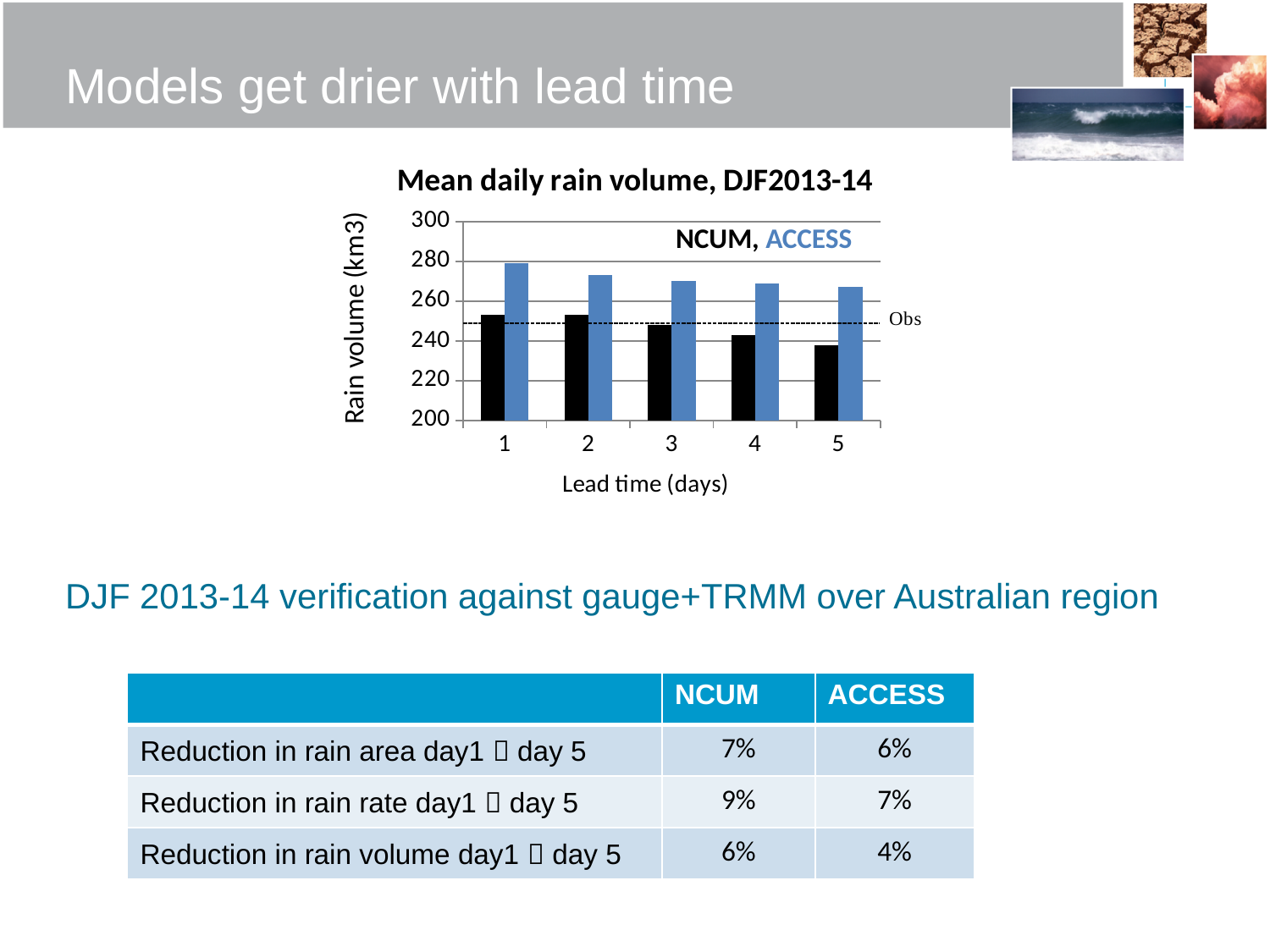
How many series does the chart's legend list? 2 What is the label of the y axis of the chart? Rain volume (km3) At which lead time is the ACCESS rain volume highest? 1 What is the title of the chart? Mean daily rain volume, DJF2013-14 What kind of chart is shown on the slide? Bar chart Is the ACCESS rain volume at lead time 5 days greater or less than 260? greater At lead time 1 day, which series has the larger rain volume, NCUM or ACCESS? ACCESS At which lead time is the NCUM rain volume lowest? 5 Is the ACCESS rain volume at lead time 1 day greater or less than 260? greater Is the NCUM rain volume at lead time 5 days greater or less than 250? less How many lead-time categories are shown on the x axis of the chart? 5 Do the NCUM rain volumes rise or fall as lead time increases from 1 to 5 days? fall